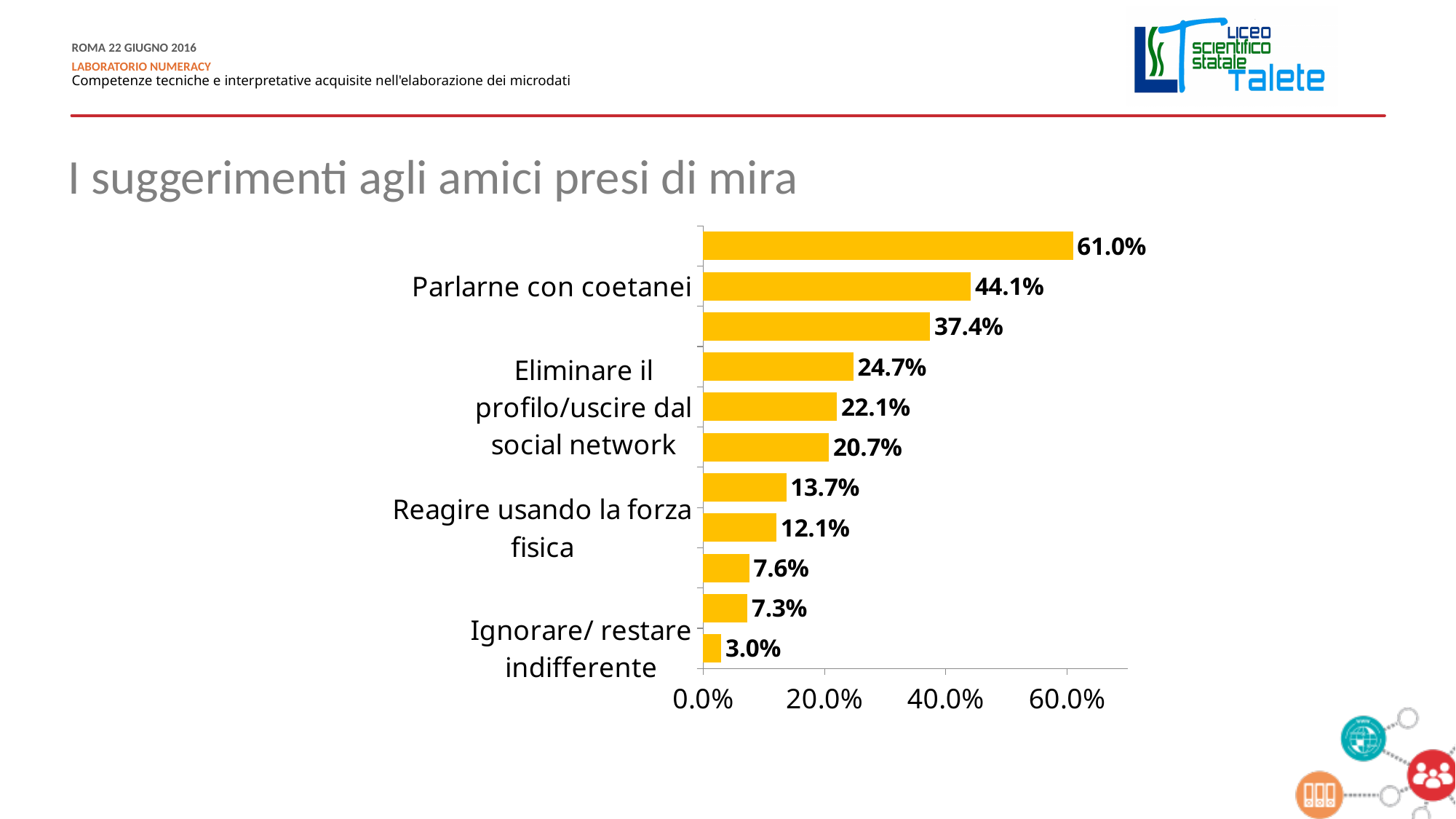
What is the highest value shown in the chart? 61.0% How many bars are plotted in the chart? 11 What is the title of the slide's chart? I suggerimenti agli amici presi di mira What is the value for 'Parlarne con coetanei'? 44.1% What type of chart is shown on the slide? Bar chart Which category has the lowest value in the chart? Ignorare/ restare indifferente What is the value for 'Reagire usando la forza fisica'? 12.1% Is the value for 'Parlarne con coetanei' greater or less than 40.0%? greater What is the difference between the values for 'Parlarne con coetanei' and 'Eliminare il profilo/uscire dal social network'? 22.0% What is the value for 'Ignorare/ restare indifferente'? 3.0% What is the value for 'Eliminare il profilo/uscire dal social network'? 22.1% Which is larger: the value for 'Reagire usando la forza fisica' or the value for 'Ignorare/ restare indifferente'? Reagire usando la forza fisica